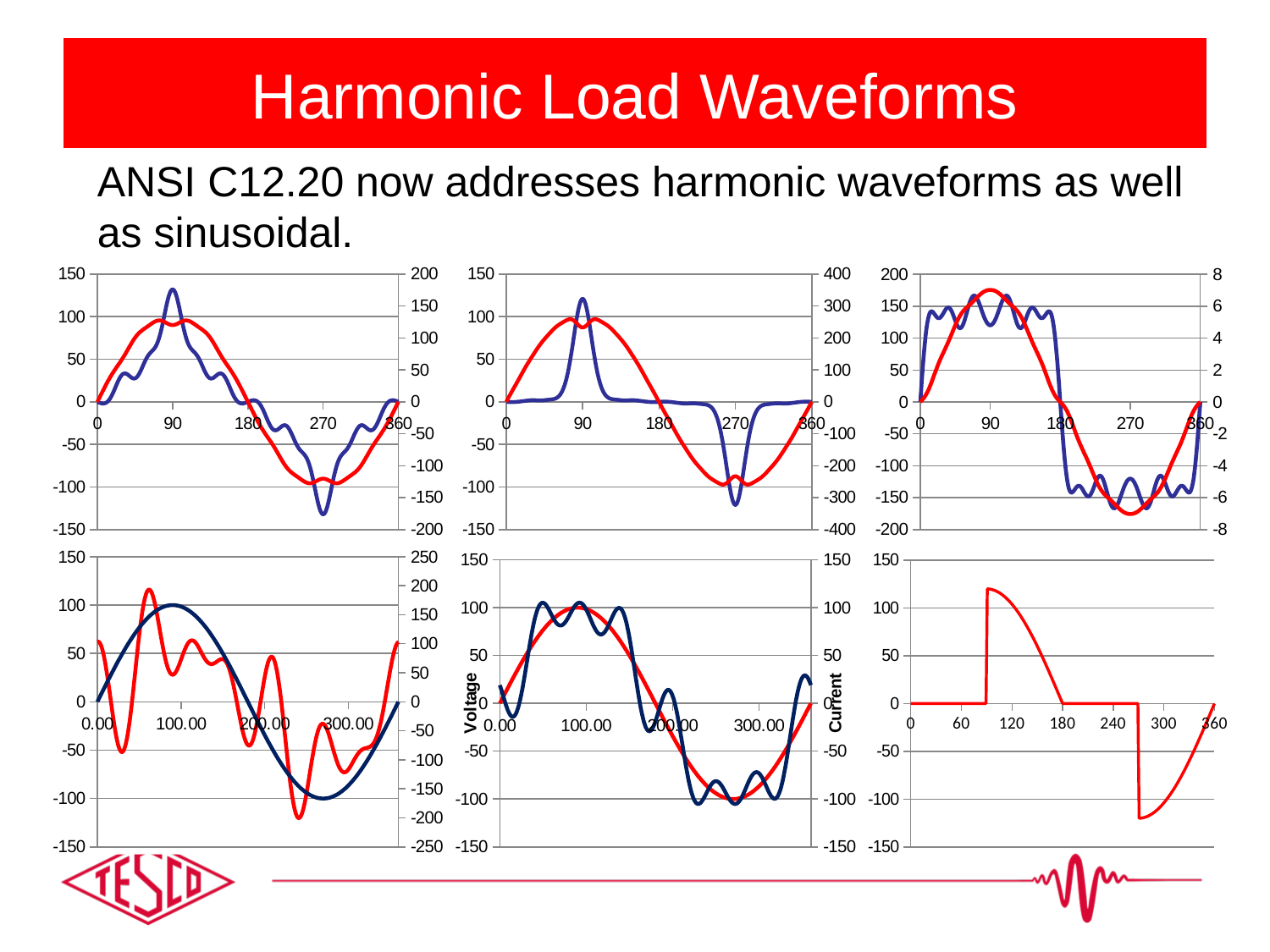
How many lines are plotted in the bottom-right chart? 1 How many tick labels are shown on the x axis of the bottom-right chart? 7 In the bottom-right chart, what is the value of the line at x = 60? 0 In the bottom-right chart, is the lowest value of the line greater or less than -100? less What kind of chart is the top-left chart on the slide? line chart In the bottom-middle chart, what is the label on the left vertical axis? Voltage In the bottom-middle chart, what is the label on the right vertical axis? Current What is the maximum value shown on the right vertical axis of the top-right chart? 8 How many lines are plotted in the top-left chart? 2 In the bottom-right chart, does the line rise or fall between x = 120 and x = 180? fall In the bottom-right chart, does the line rise or fall between x = 300 and x = 360? rise In the bottom-right chart, is the peak value of the line greater or less than 100? greater